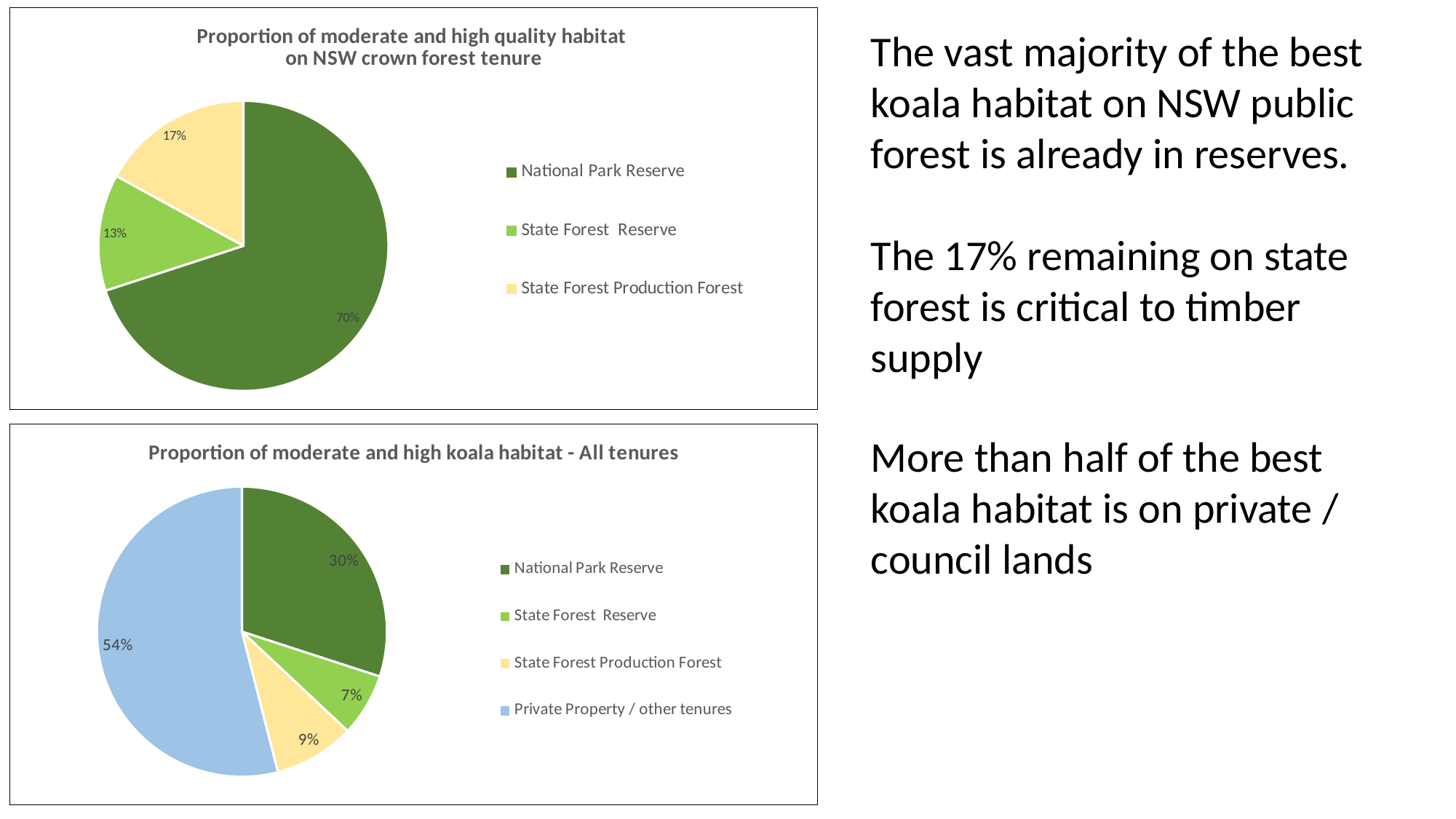
In the top chart (Proportion of moderate and high quality habitat on NSW crown forest tenure), what share is National Park Reserve? 70% In the bottom chart, which category has the smallest slice? State Forest Reserve In the top chart, how many slices does the pie have? 3 In the bottom chart, what share is State Forest Production Forest? 9% In the top chart, which category has the smallest slice? State Forest Reserve In the top chart, which category has the largest slice? National Park Reserve What type of chart is the bottom chart? Pie chart In the top chart, what share is State Forest Production Forest? 17% In the bottom chart, what is the difference in percentage points between Private Property / other tenures and National Park Reserve? 24 In the bottom chart (Proportion of moderate and high koala habitat - All tenures), what share is Private Property / other tenures? 54% In the bottom chart, what share is National Park Reserve? 30% In the top chart, what share is State Forest Reserve? 13%